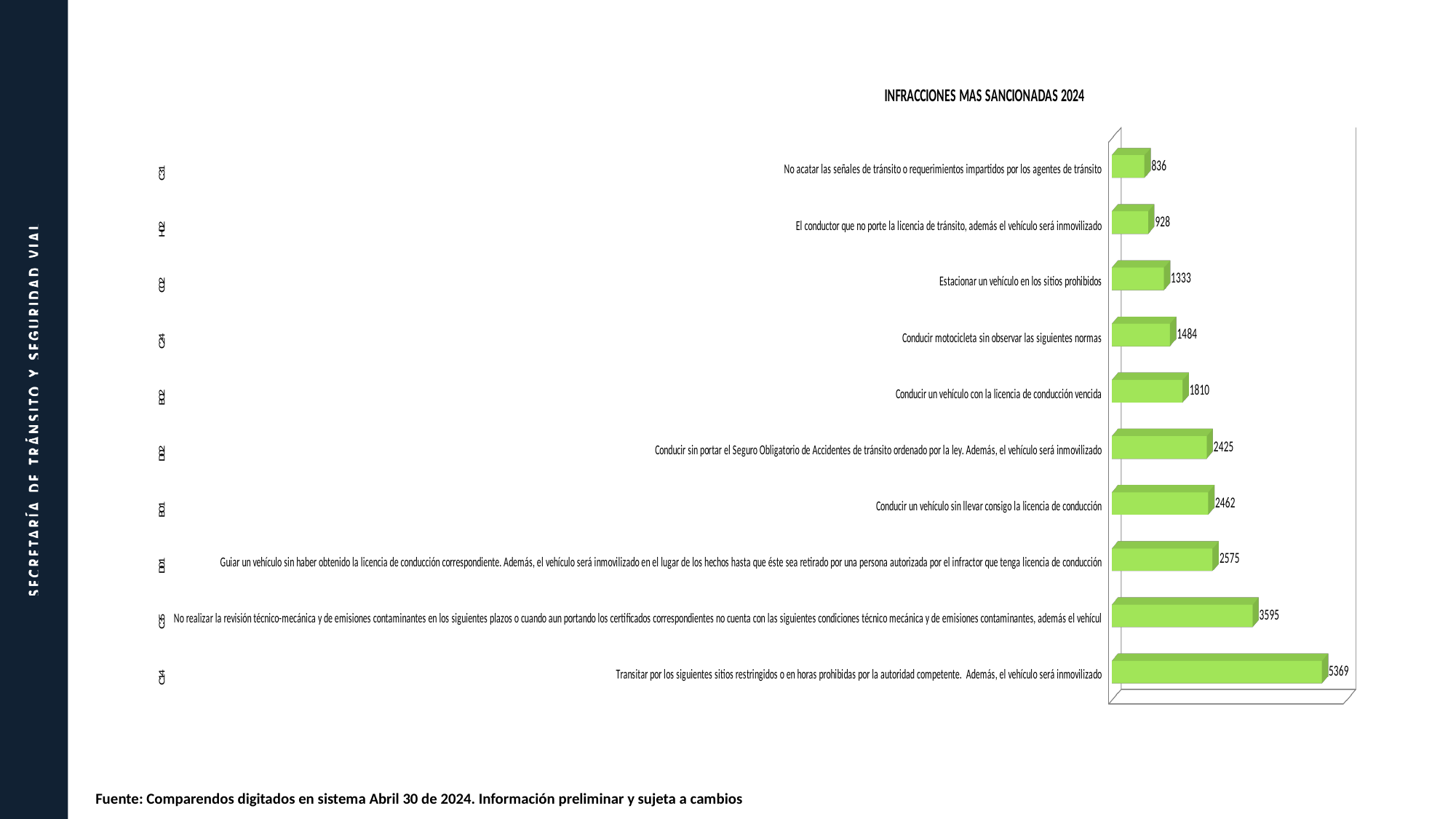
What kind of chart is shown on the slide? Bar chart How many infraction categories are plotted in the chart? 10 What is the title of the chart? INFRACCIONES MAS SANCIONADAS 2024 What is the difference between the value for "Transitar por los siguientes sitios restringidos..." (5369) and the value for "No realizar la revisión técnico-mecánica..." (3595)? 1774 What is the value for "El conductor que no porte la licencia de tránsito, además el vehículo será inmovilizado"? 928 Which is larger: the value for "Conducir sin portar el Seguro Obligatorio de Accidentes de tránsito..." or the value for "Conducir un vehículo con la licencia de conducción vencida"? Conducir sin portar el Seguro Obligatorio de Accidentes de tránsito ordenado por la ley. Además, el vehículo será inmovilizado What is the value for "Conducir motocicleta sin observar las siguientes normas"? 1484 Which infraction has the lowest value in the chart? No acatar las señales de tránsito o requerimientos impartidos por los agentes de tránsito Which infraction has the highest value in the chart? Transitar por los siguientes sitios restringidos o en horas prohibidas por la autoridad competente. Además, el vehículo será inmovilizado What is the difference between the value for "Conducir motocicleta sin observar las siguientes normas" and the value for "Estacionar un vehículo en los sitios prohibidos"? 151 What is the value for "Estacionar un vehículo en los sitios prohibidos"? 1333 What is the value for "Conducir un vehículo con la licencia de conducción vencida"? 1810